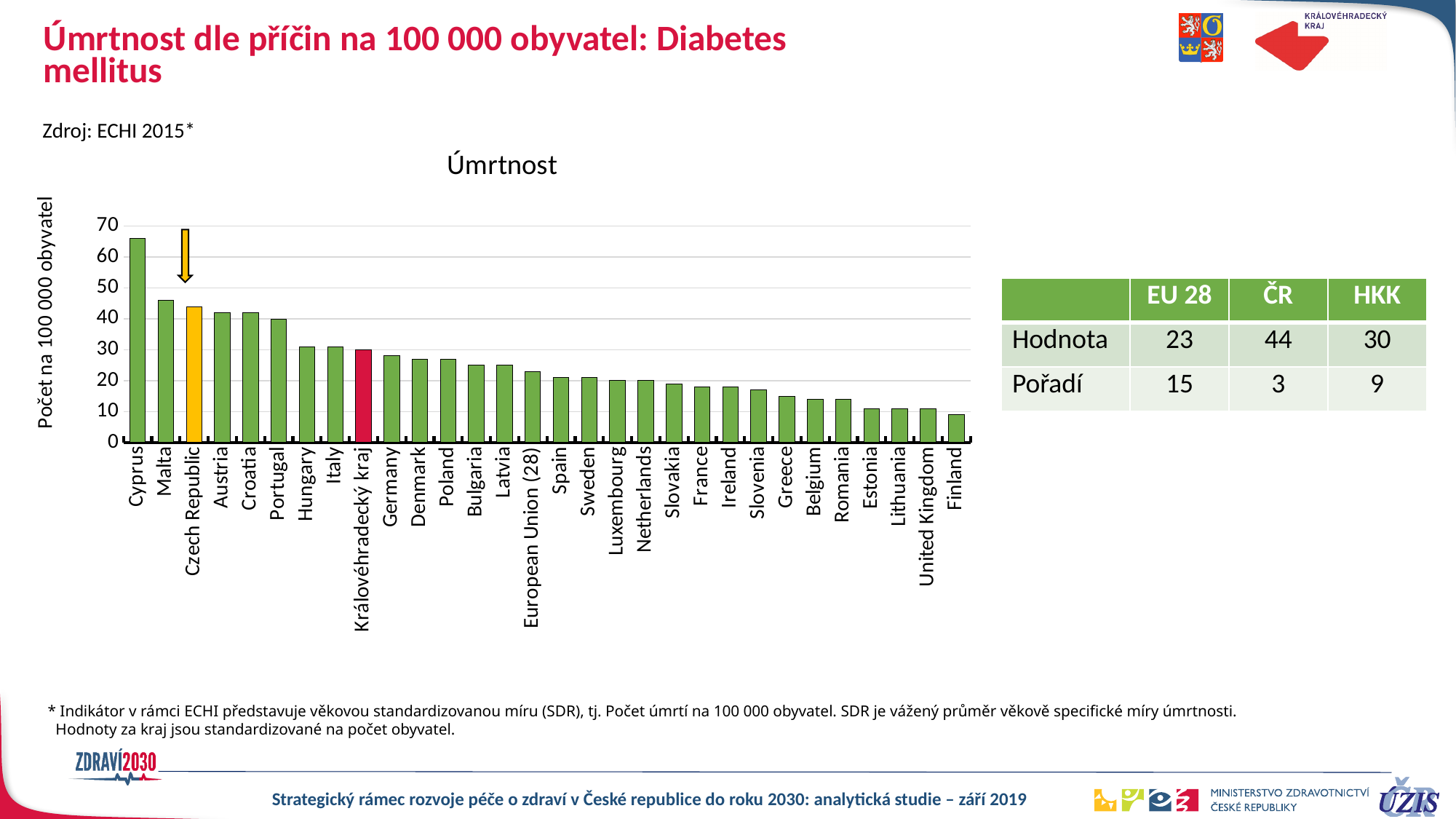
According to the table on the slide, what is the value (Hodnota) for HKK? 30 Which country has the lowest value in the chart? Finland Which has the larger value, Malta or Austria? Malta What kind of chart is shown on the slide? bar chart According to the table on the slide, what is the value (Hodnota) for ČR? 44 Is the value for Cyprus greater or less than 60? greater How many bars (categories) are plotted in the chart? 30 Do the values rise or fall from left to right along the x axis? fall What is the title of the chart? Úmrtnost Is the value for Spain greater or less than 30? less Is the value for Malta greater or less than 50? less Which country has the highest diabetes mellitus mortality in the chart? Cyprus